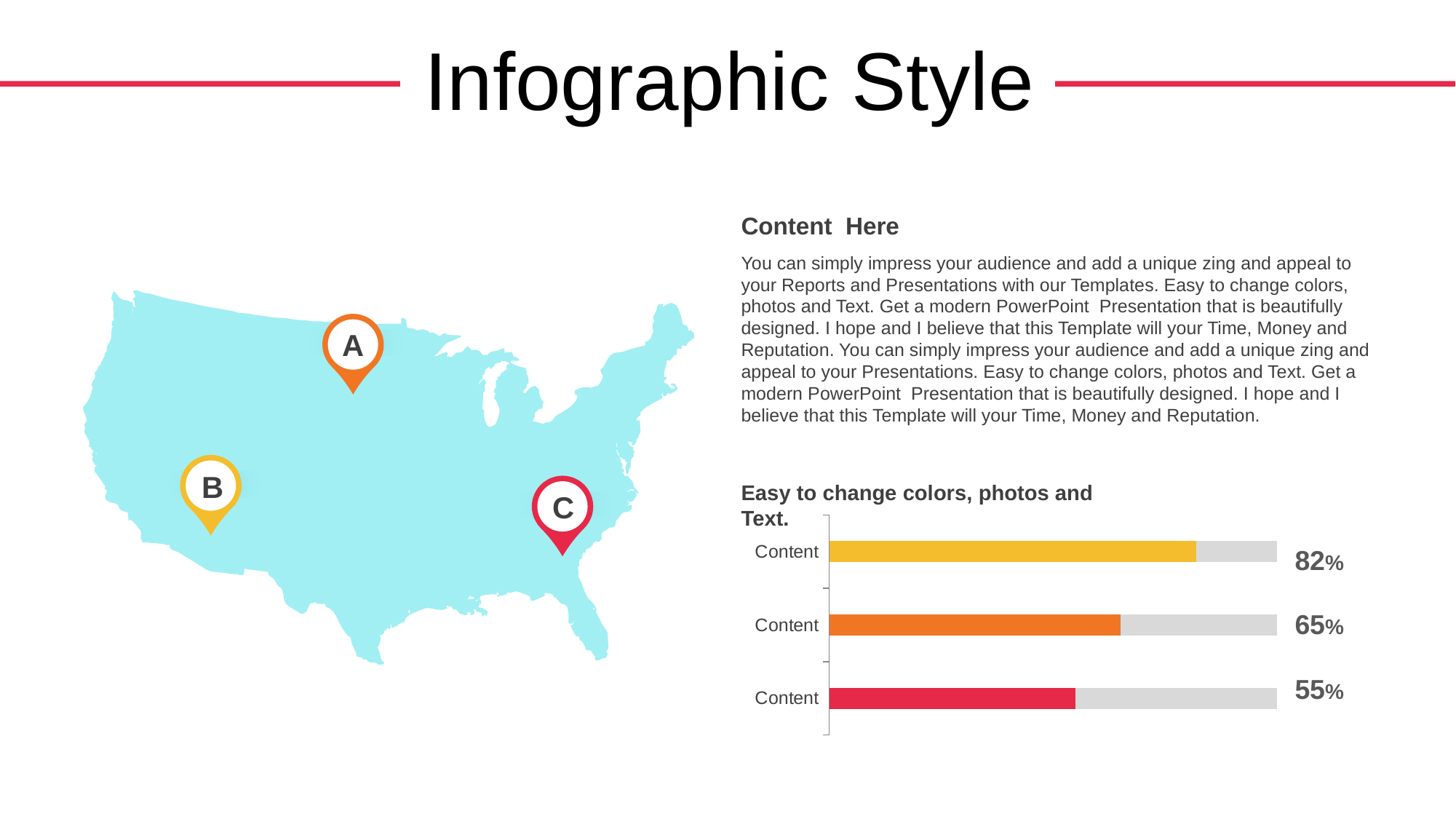
What kind of chart is shown on the right side of the slide? bar chart How many bars does the chart on the slide have? 3 Which bar in the chart has the lowest value? the bottom (red) bar, 55% What is the difference between the top bar's value and the bottom bar's value? 27% Do the bar values increase or decrease going from the top bar to the bottom bar? decrease Which is larger, the value of the middle (orange) bar or the bottom (red) bar? the middle (orange) bar What is the value of the bottom (red) bar in the chart? 55% What is the value of the top (yellow) bar in the chart? 82% Which bar in the chart has the highest value? the top (yellow) bar, 82% What is the value of the middle (orange) bar in the chart? 65% What label is shown next to each bar on the chart's category axis? Content What is the difference between the top bar's value and the middle bar's value? 17%